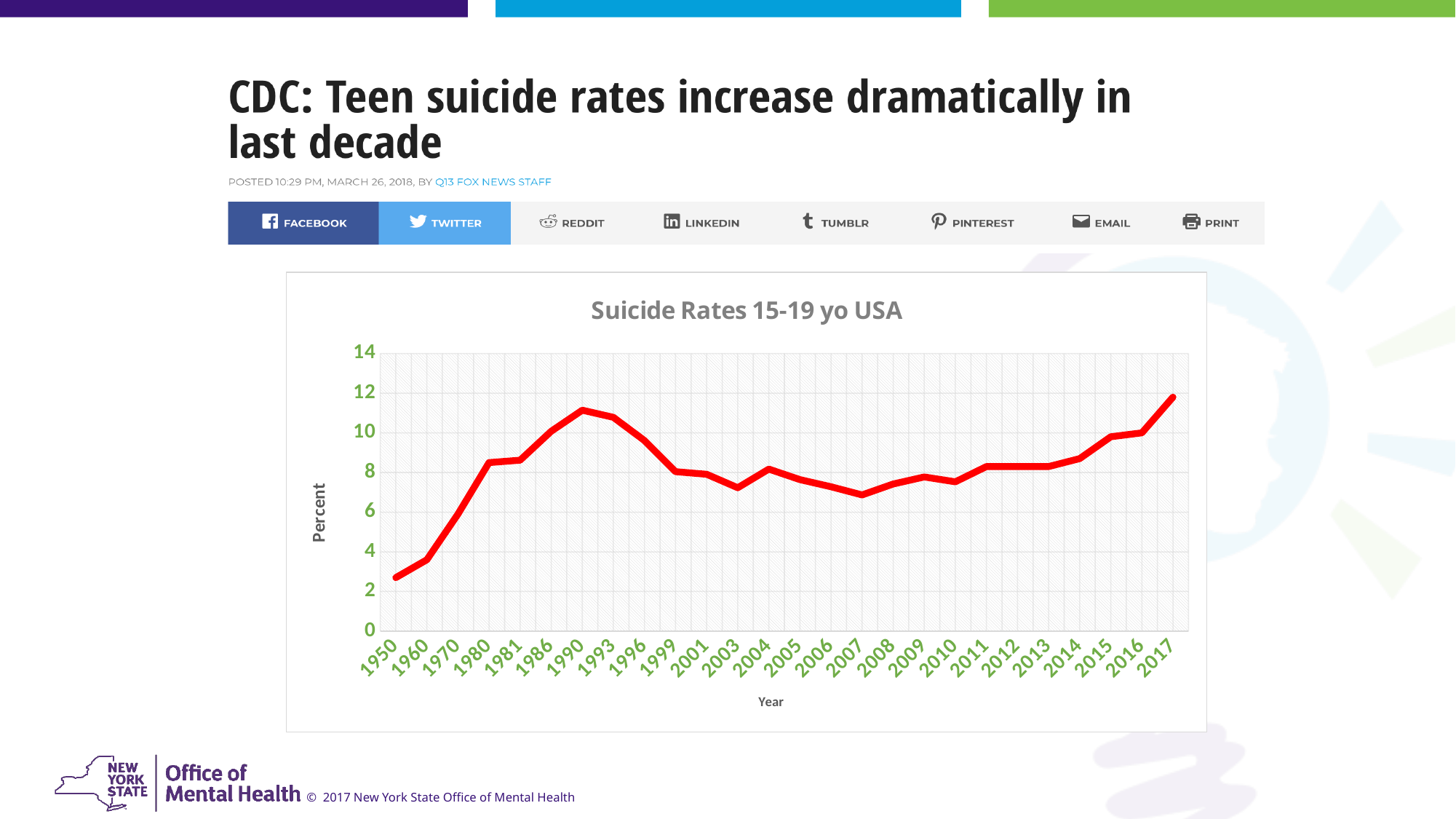
How many years are plotted along the x axis of the chart? 26 Which year has the larger value, 1990 or 2007? 1990 What is the title of the chart? Suicide Rates 15-19 yo USA Which year has the lowest value on the chart? 1950 Is the value for 2017 greater or less than 10? greater What is the label on the vertical axis of the chart? Percent What kind of chart is shown on the slide? line chart Is the value for 1990 greater or less than 10? greater Is the value for 2007 greater or less than 8? less Do the values rise or fall from 2007 to 2017? rise Which year has the highest value on the chart? 2017